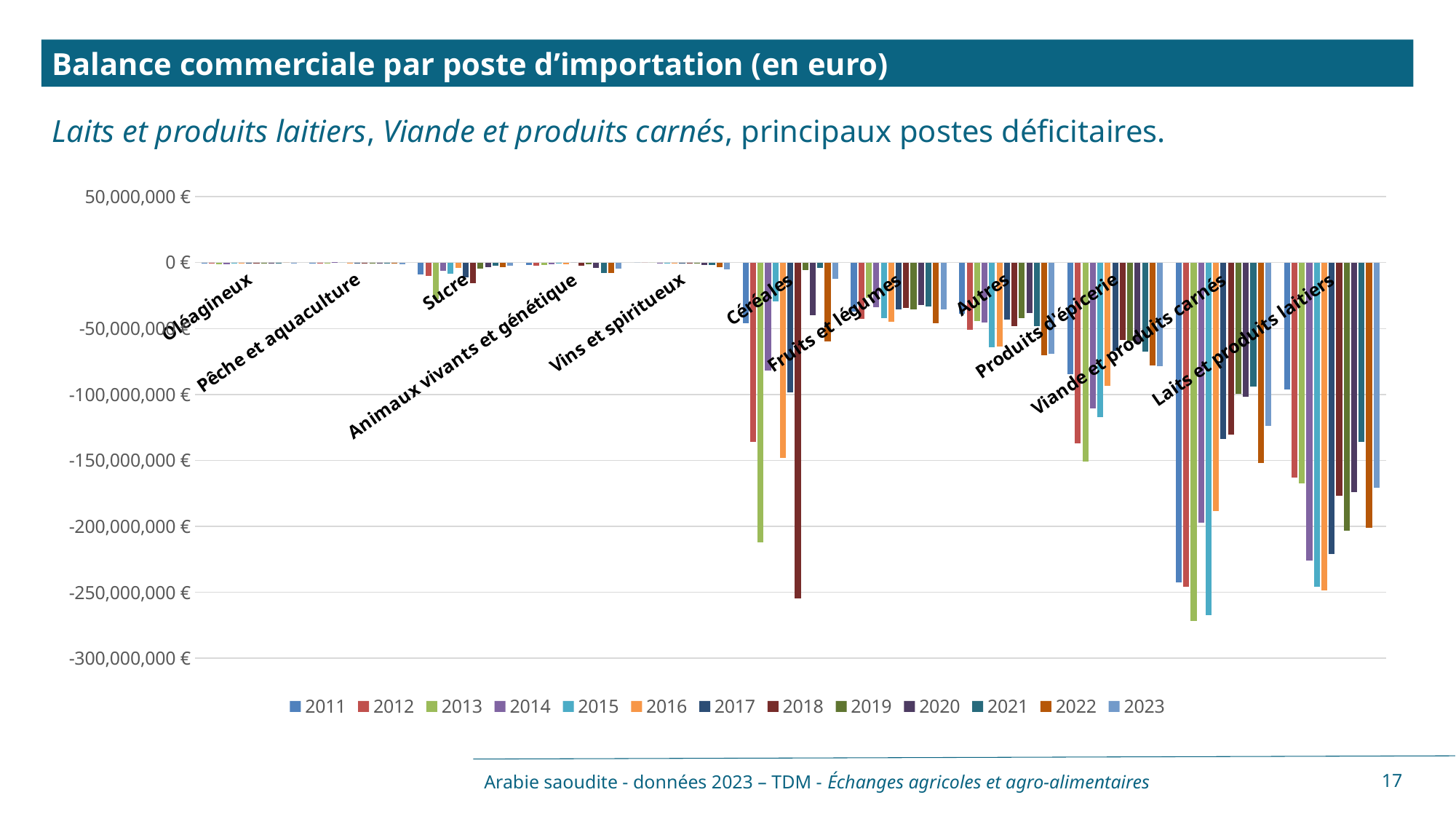
What is the title of the chart? Balance commerciale par poste d’importation (en euro) Is the value for Produits d'épicerie in 2012 greater or less than -100,000,000 €? less Is the value for Céréales in 2013 greater or less than -200,000,000 €? less What kind of chart is shown on the slide? bar chart Is the value for Viande et produits carnés in 2013 greater or less than -250,000,000 €? less How many series (years) does the chart legend list? 13 Which years are the first and last series listed in the chart legend? 2011 and 2023 Which category contains the lowest (most negative) bar on the chart? Viande et produits carnés Which has the larger deficit in 2013: Viande et produits carnés or Laits et produits laitiers? Viande et produits carnés How many import categories are shown on the x axis of the chart? 11